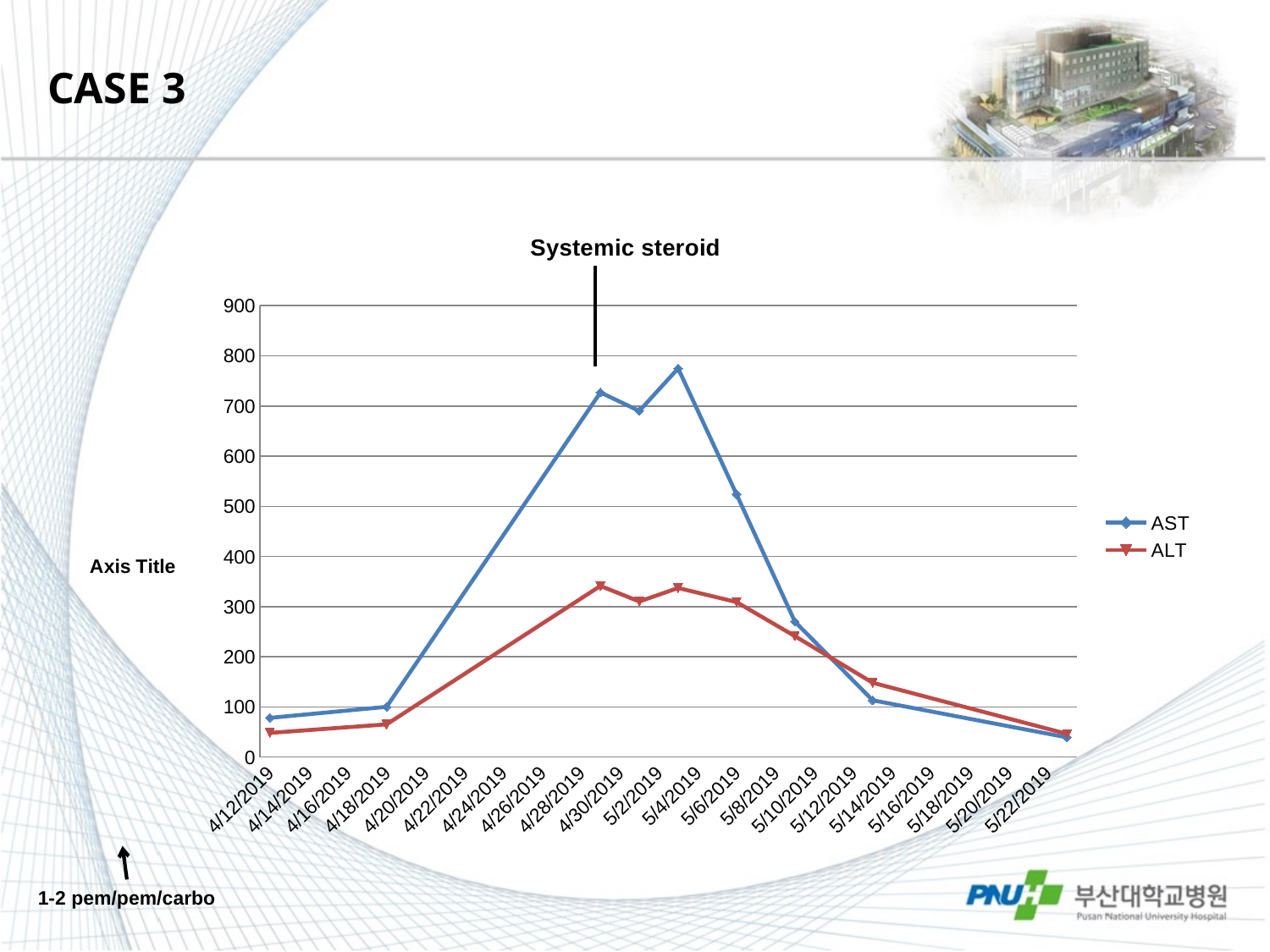
Is the ALT value on 5/8/2019 greater or less than 300? less Is the AST value on 4/12/2019 greater or less than 100? less Does the AST series rise or fall between 5/4/2019 and 5/22/2019? fall What annotation is written above the vertical marker line on the chart? Systemic steroid What kind of chart is shown on the slide? line chart Which series has the larger value on 5/4/2019, AST or ALT? AST Which series has the larger value on 5/14/2019, AST or ALT? ALT How many series does the legend list? 2 Which two series are listed in the legend? AST and ALT